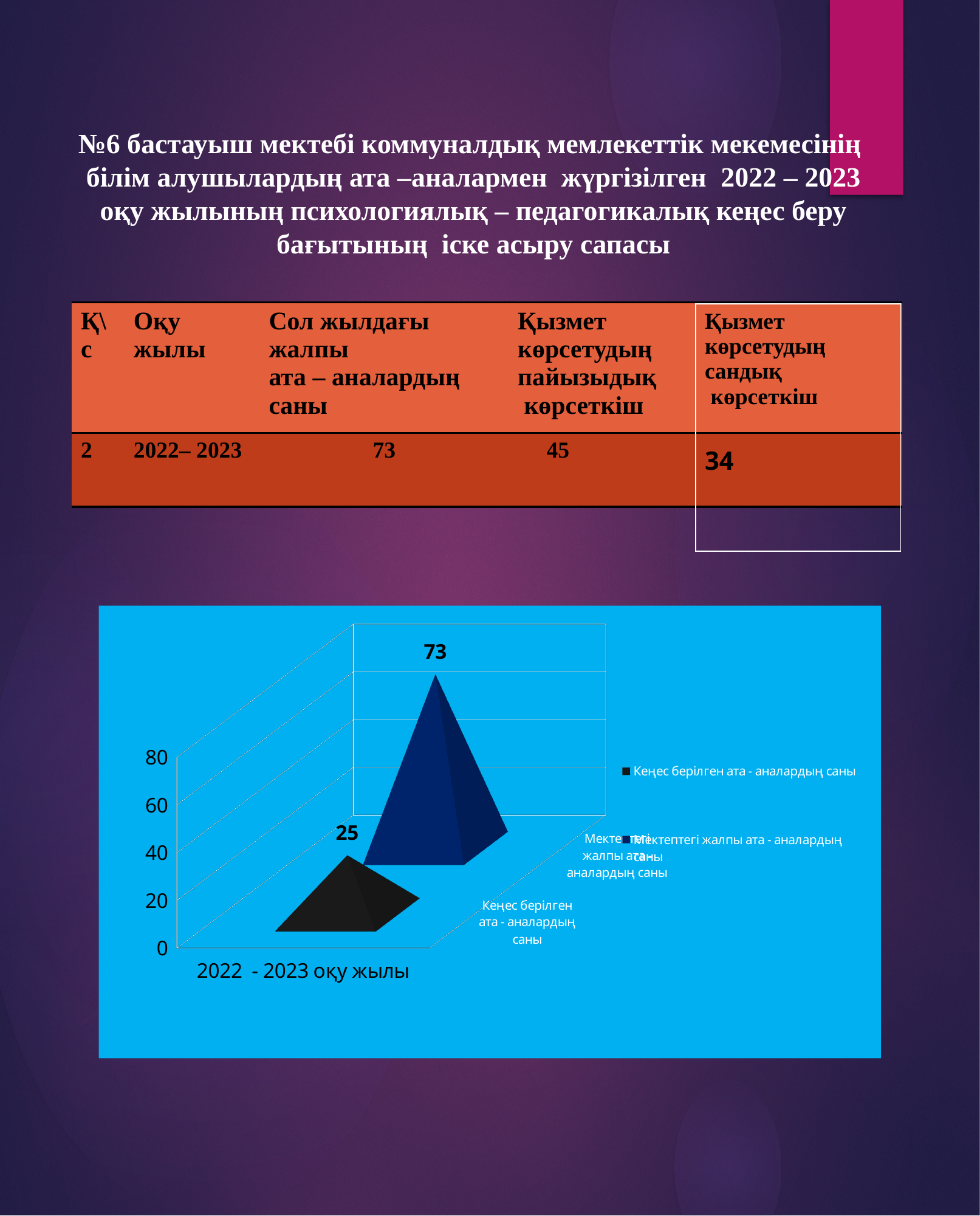
What value is shown for the series 'Кеңес берілген ата - аналардың саны' in the chart? 25 Is the value for 'Кеңес берілген ата - аналардың саны' greater or less than 40? less How many series does the chart legend list? 2 Which series has the lower value in the chart? Кеңес берілген ата - аналардың саны What is the difference between the values 73 and 25 shown in the chart? 48 What category label is shown on the x axis of the chart? 2022 - 2023 оқу жылы What is the highest value shown on the vertical axis of the chart? 80 Is the value for 'Мектептегі жалпы ата - аналардың саны' greater or less than 60? greater Which series has the higher value in the chart? Мектептегі жалпы ата - аналардың саны Is the value for 'Кеңес берілген ата - аналардың саны' larger or smaller than the value for 'Мектептегі жалпы ата - аналардың саны'? smaller What value is shown for the series 'Мектептегі жалпы ата - аналардың саны' in the chart? 73 How many categories are shown on the x axis of the chart? 1